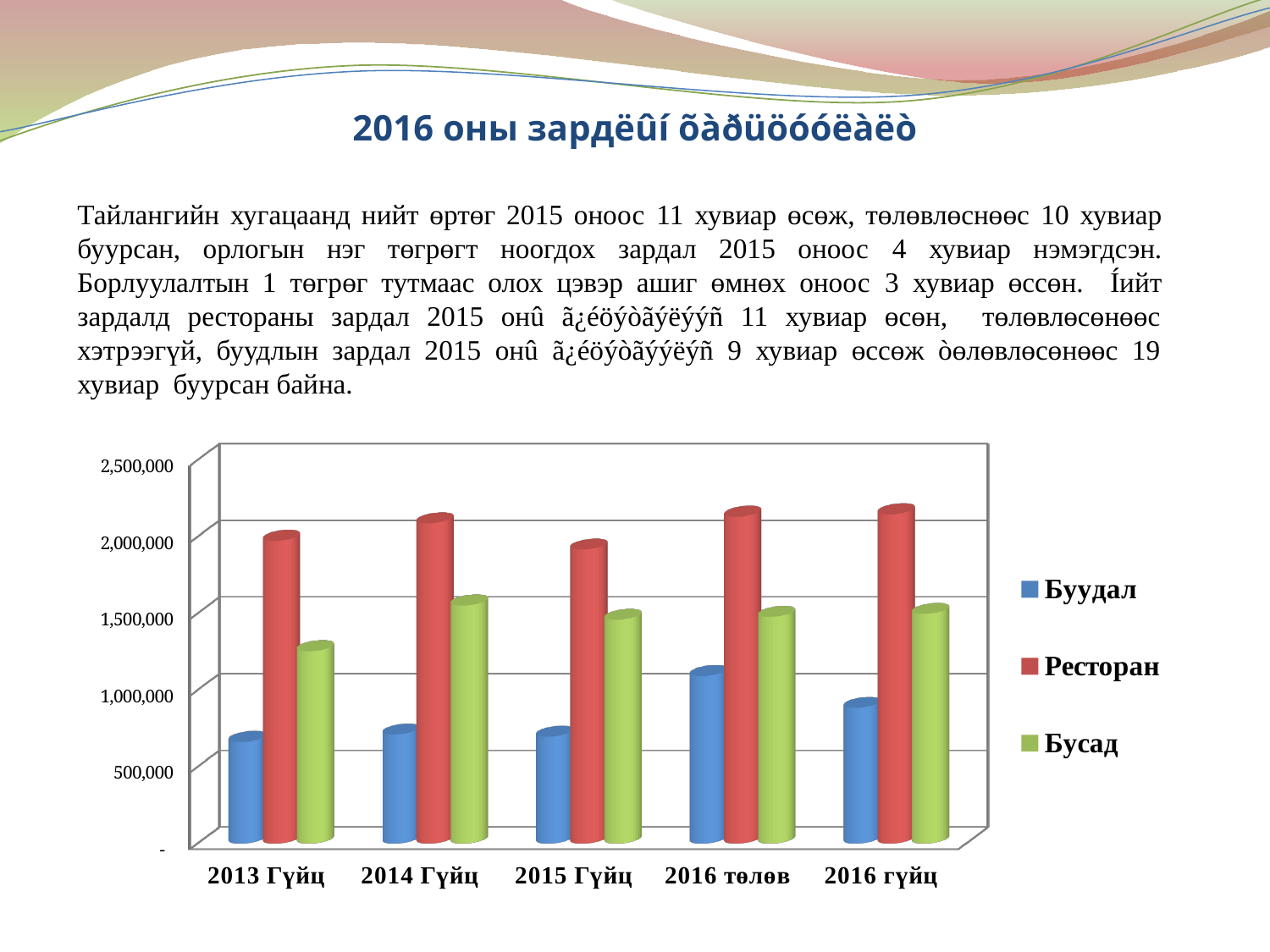
In 2014 Гүйц, which is larger: Ресторан or Бусад? Ресторан Is the value for Буудал in 2013 Гүйц greater or less than 1,000,000? less Is the value for Бусад in 2013 Гүйц greater or less than 1,500,000? less How many series does the chart legend list? 3 What kind of chart is shown on the slide? Bar chart Which series has the lowest value in the 2015 Гүйц category? Буудал Which series has the highest value in the 2013 Гүйц category? Ресторан In which category is the Бусад series lowest? 2013 Гүйц How many categories are shown along the x axis of the chart? 5 What colour represents the Ресторан series in the chart? Red Is the value for Ресторан in 2013 Гүйц greater or less than 1,500,000? greater In which category is the Буудал series highest? 2016 төлөв